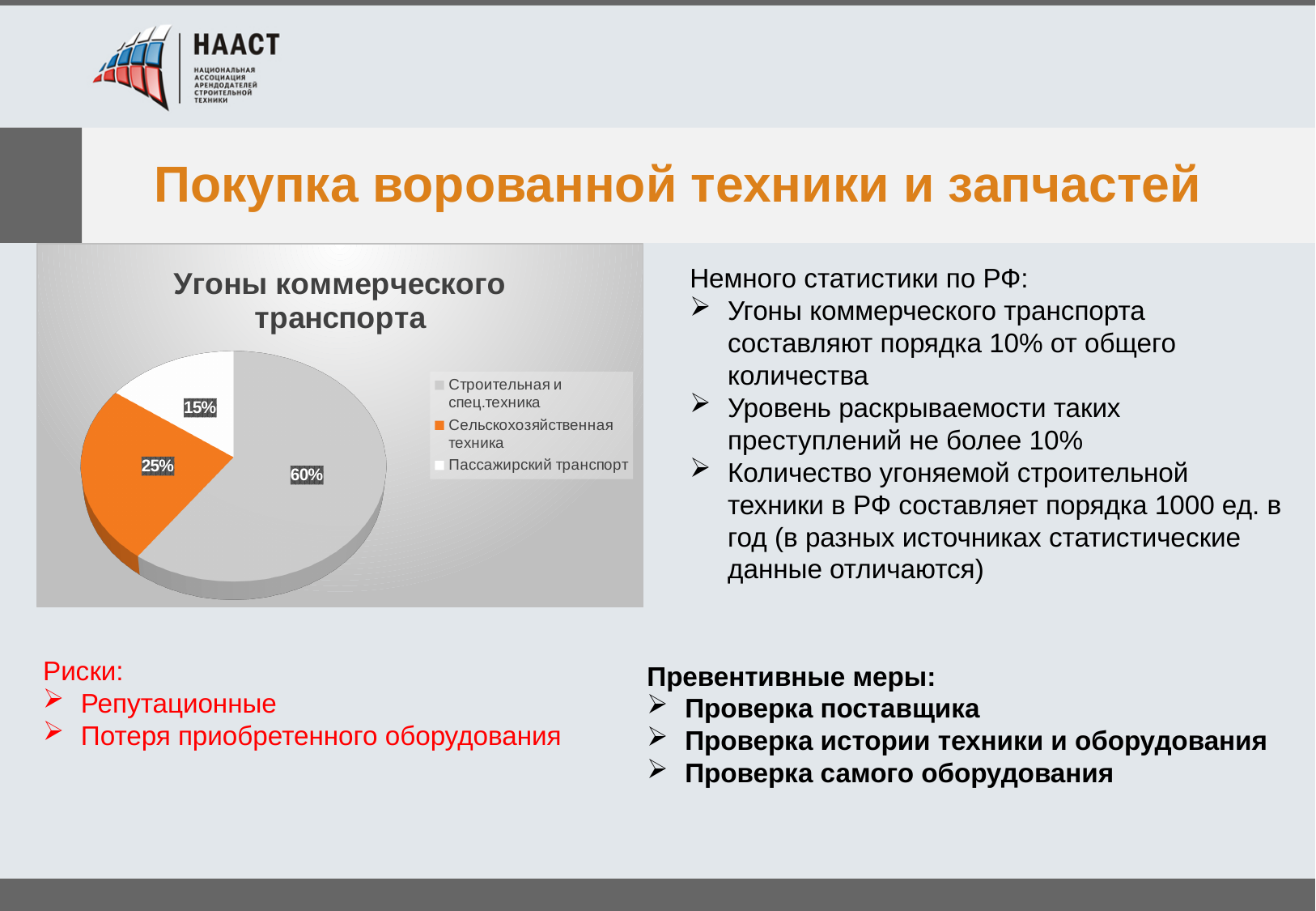
What is the difference between the shares of Строительная и спец.техника and Сельскохозяйственная техника? 35% Which is larger: the share of Сельскохозяйственная техника or Пассажирский транспорт? Сельскохозяйственная техника What is the title of the chart? Угоны коммерческого транспорта How many categories does the pie chart show? 3 What share of the pie does Пассажирский транспорт have? 15% What is the difference between the shares of Сельскохозяйственная техника and Пассажирский транспорт? 10% What share of the pie does Сельскохозяйственная техника have? 25% What colour is the slice for Сельскохозяйственная техника? Orange Which category has the smallest slice of the pie? Пассажирский транспорт Which category has the largest slice of the pie? Строительная и спец.техника What kind of chart is shown on the slide? Pie chart What share of the pie does Строительная и спец.техника have? 60%